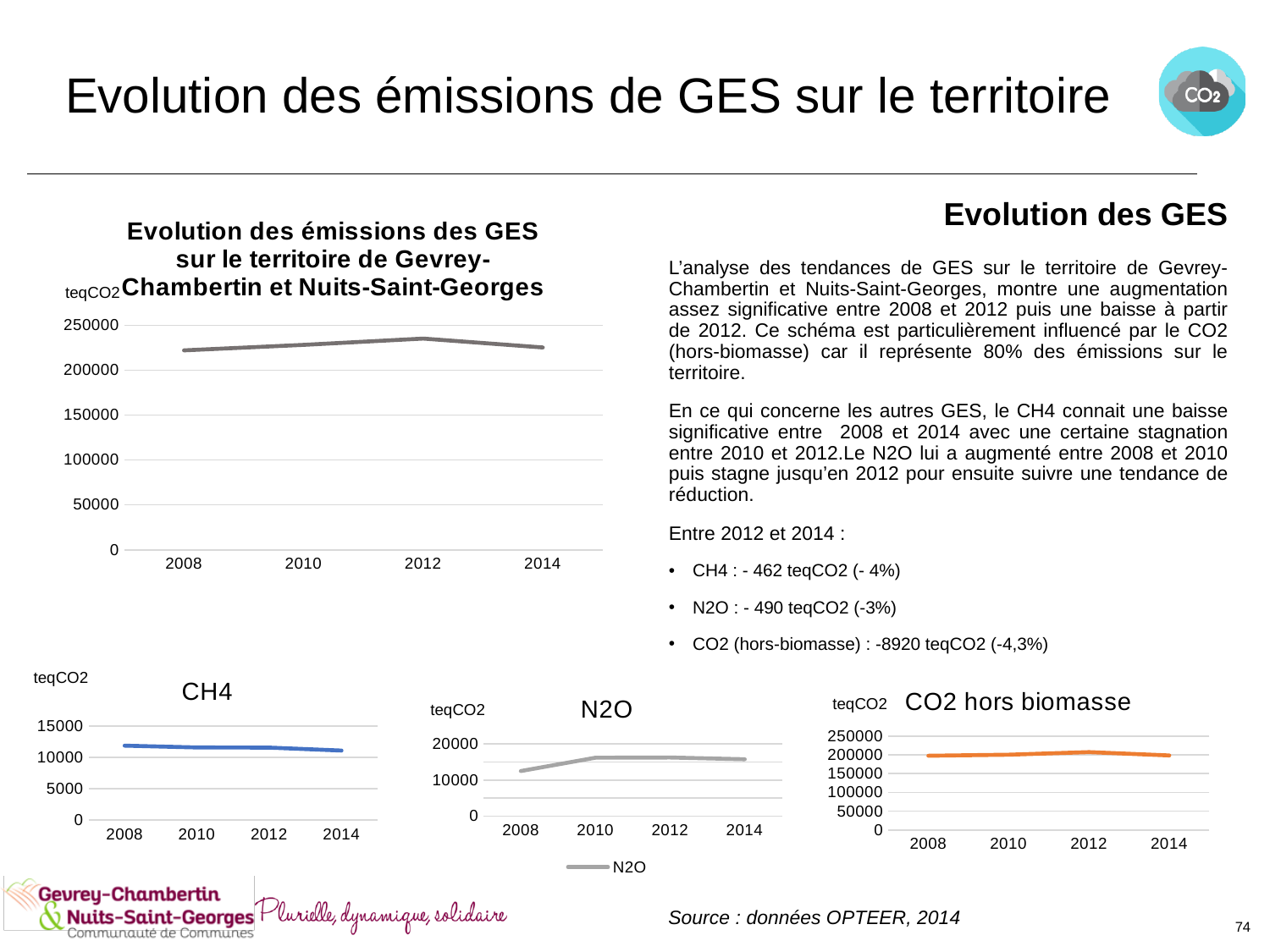
In the CH4 chart, is the value for 2008 greater or less than 10000? greater What kind of chart is the 'Evolution des émissions des GES sur le territoire de Gevrey-Chambertin et Nuits-Saint-Georges' chart? line chart In the 'Evolution des émissions des GES sur le territoire de Gevrey-Chambertin et Nuits-Saint-Georges' chart, is the value for 2008 greater or less than 200000? greater In the CH4 chart, which year has the lowest value? 2014 In the 'Evolution des émissions des GES sur le territoire de Gevrey-Chambertin et Nuits-Saint-Georges' chart, which year has the highest value? 2012 In the 'Evolution des émissions des GES sur le territoire de Gevrey-Chambertin et Nuits-Saint-Georges' chart, how many years are plotted on the x axis? 4 In the 'Evolution des émissions des GES sur le territoire de Gevrey-Chambertin et Nuits-Saint-Georges' chart, is the value for 2012 greater or less than 250000? less How many series does the legend of the N2O chart list? 1 In the CH4 chart, do the values rise or fall from 2008 to 2014? fall In the N2O chart, which year has the lowest value? 2008